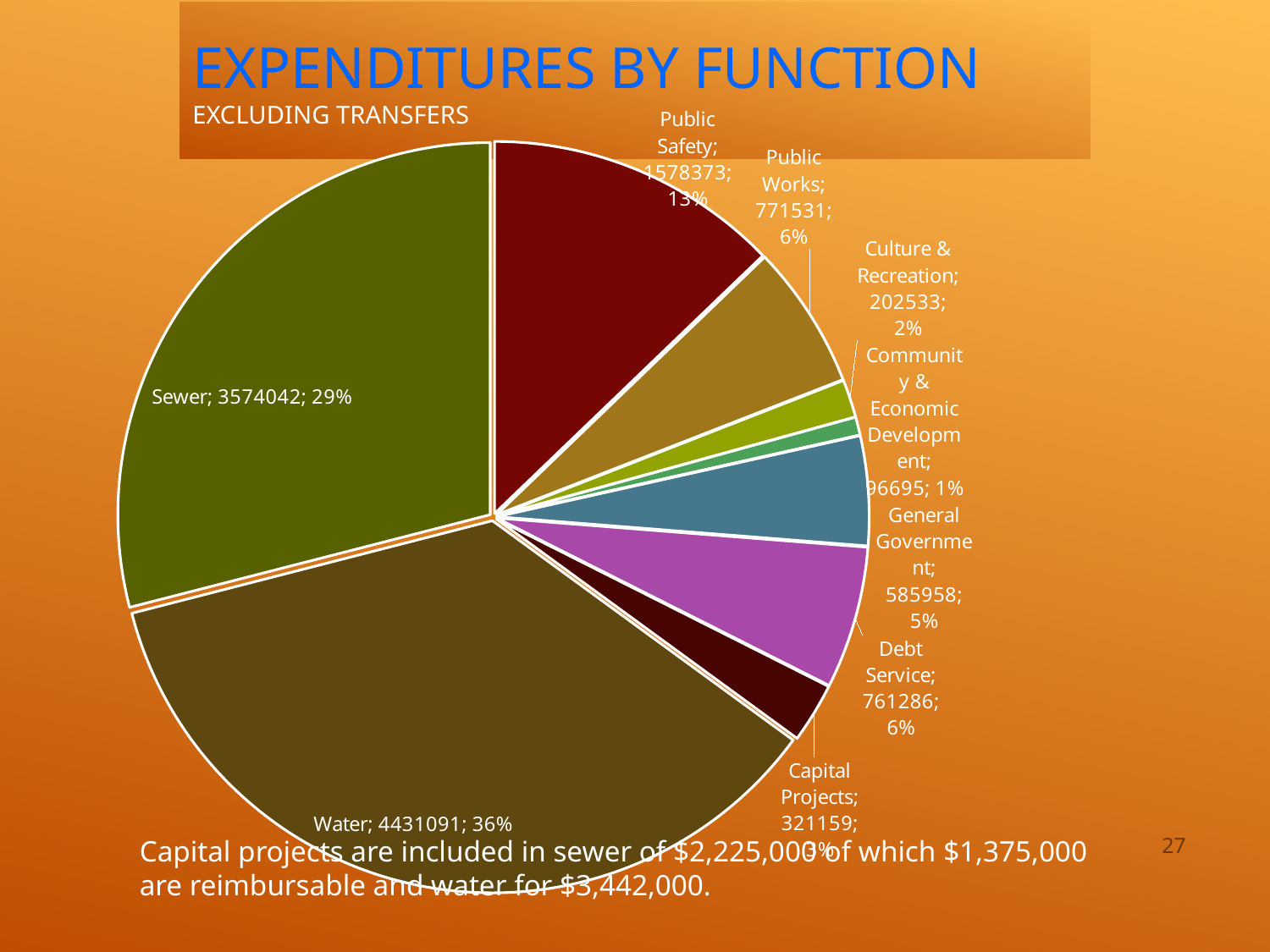
How many categories are shown in the pie chart? 9 What is the difference between the Public Safety and Public Works values? 806842 Which is larger, Public Safety or General Government? Public Safety What is the value for Debt Service in the pie chart? 761286 What percentage share does Sewer have in the pie chart? 29% Which category has the largest slice of the pie chart? Water What is the title of the chart? EXPENDITURES BY FUNCTION EXCLUDING TRANSFERS What is the value for Water in the pie chart? 4431091 Which category has the smallest slice of the pie chart? Community & Economic Development What is the difference between the Water and Sewer values? 857049 What percentage share does Public Safety have in the pie chart? 13% What kind of chart is shown on the slide? Pie chart